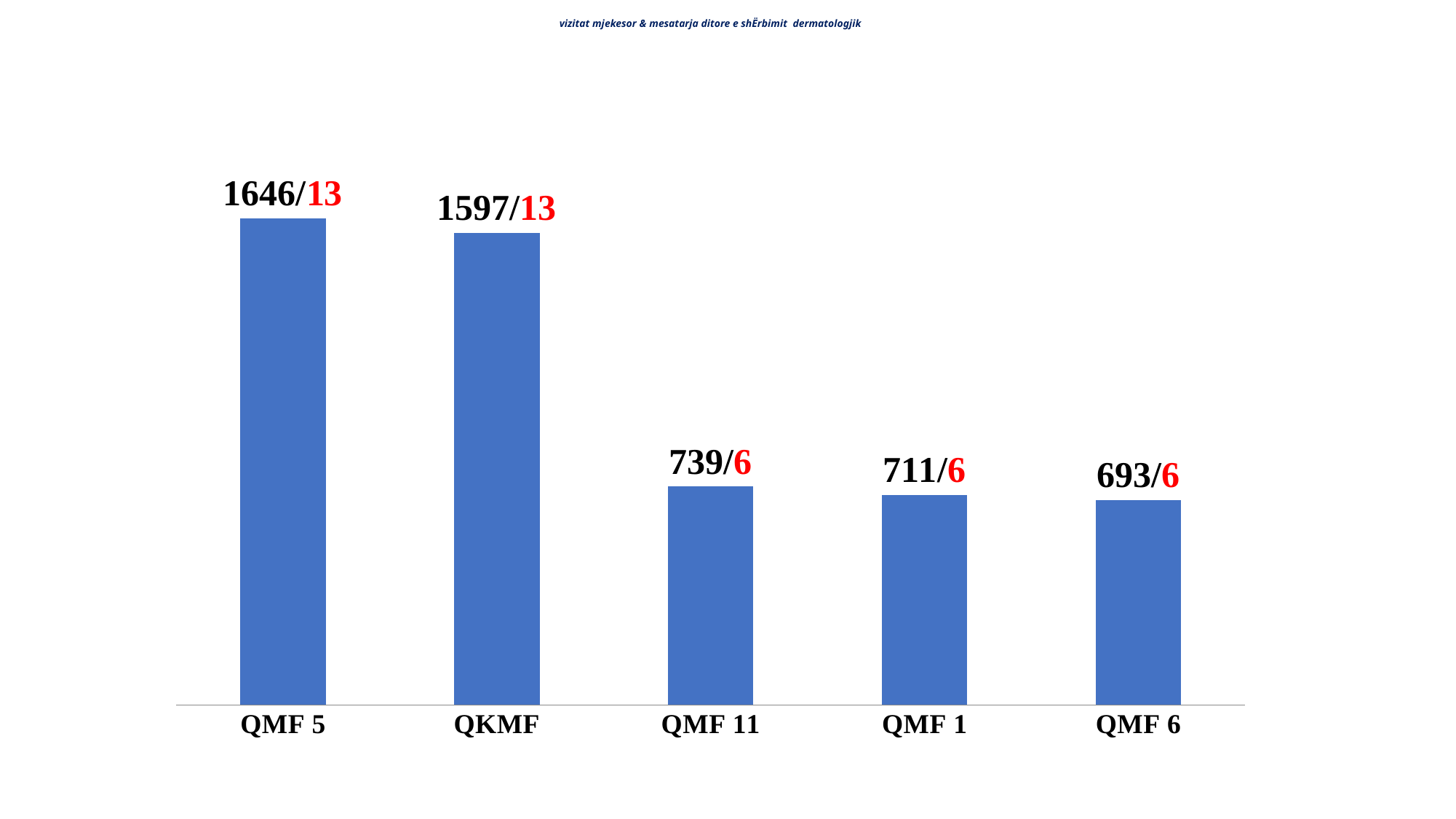
How many categories are shown on the x axis? 5 What is the data label shown above the bar for QKMF? 1597/13 Which category has the tallest bar? QMF 5 Which has a taller bar, QKMF or QMF 11? QKMF Do the bar values rise or fall from left to right along the x axis? Fall What is the data label shown above the bar for QMF 11? 739/6 Which category has the shortest bar? QMF 6 What is the difference between the number of visits for QMF 11 (739) and QMF 1 (711)? 28 What is the difference between the number of visits for QMF 5 (1646) and QKMF (1597)? 49 What kind of chart is shown on the slide? Bar chart What is the data label shown above the bar for QMF 6? 693/6 What is the data label shown above the bar for QMF 5? 1646/13